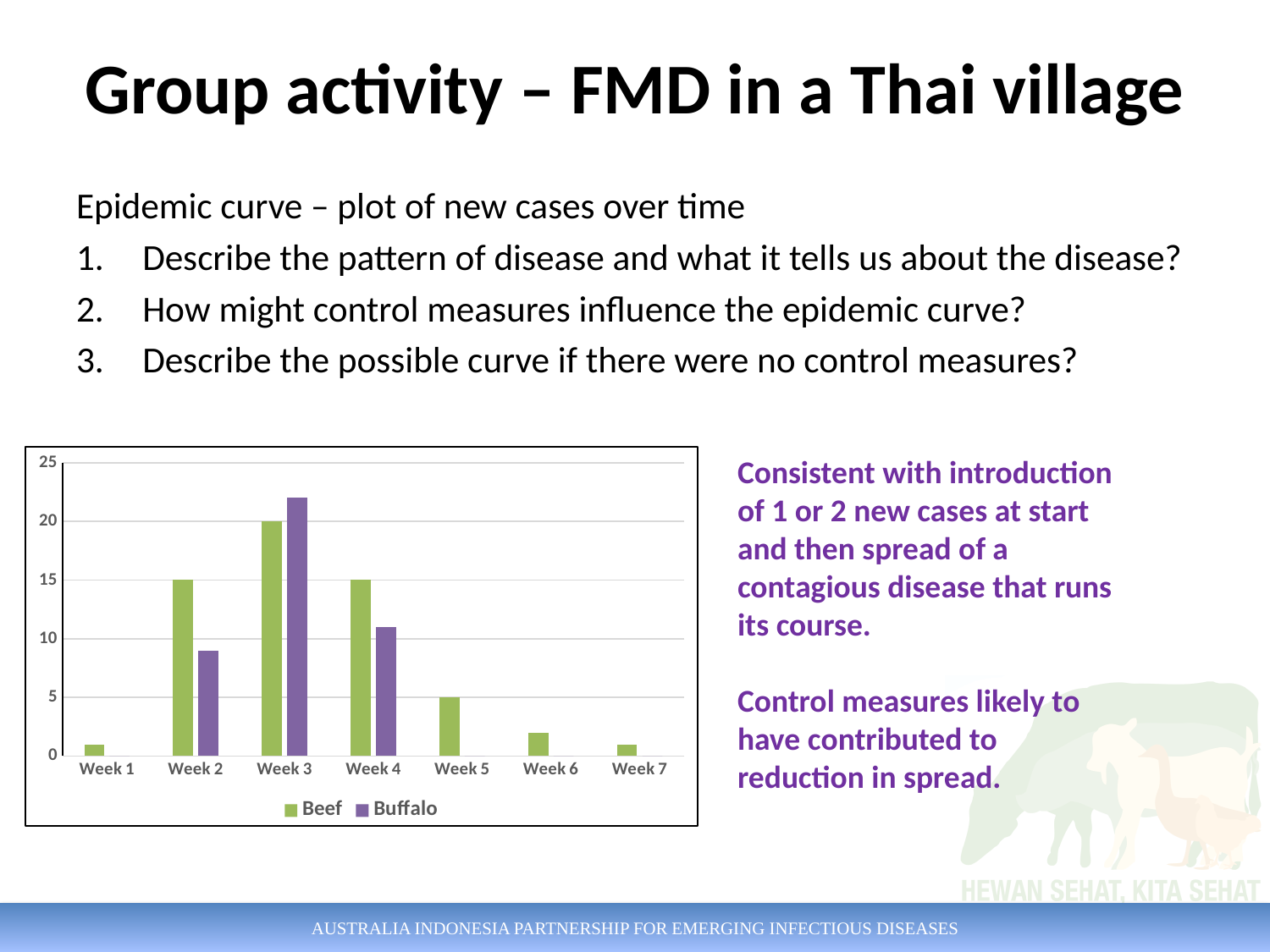
In Week 2, which series has the larger value, Beef or Buffalo? Beef What is the Beef value for Week 5? 5 How many series does the chart legend list? 2 Is the Buffalo value for Week 3 greater or less than 20? greater What type of chart is shown on the slide? bar chart What is the Beef value for Week 3? 20 Is the Buffalo value for Week 2 greater or less than 10? less In which week is the Buffalo value highest? Week 3 How many weeks are shown on the x axis of the chart? 7 What is the difference between the Beef values for Week 3 and Week 5? 15 What is the Beef value for Week 2? 15 In which week is the Beef value highest? Week 3